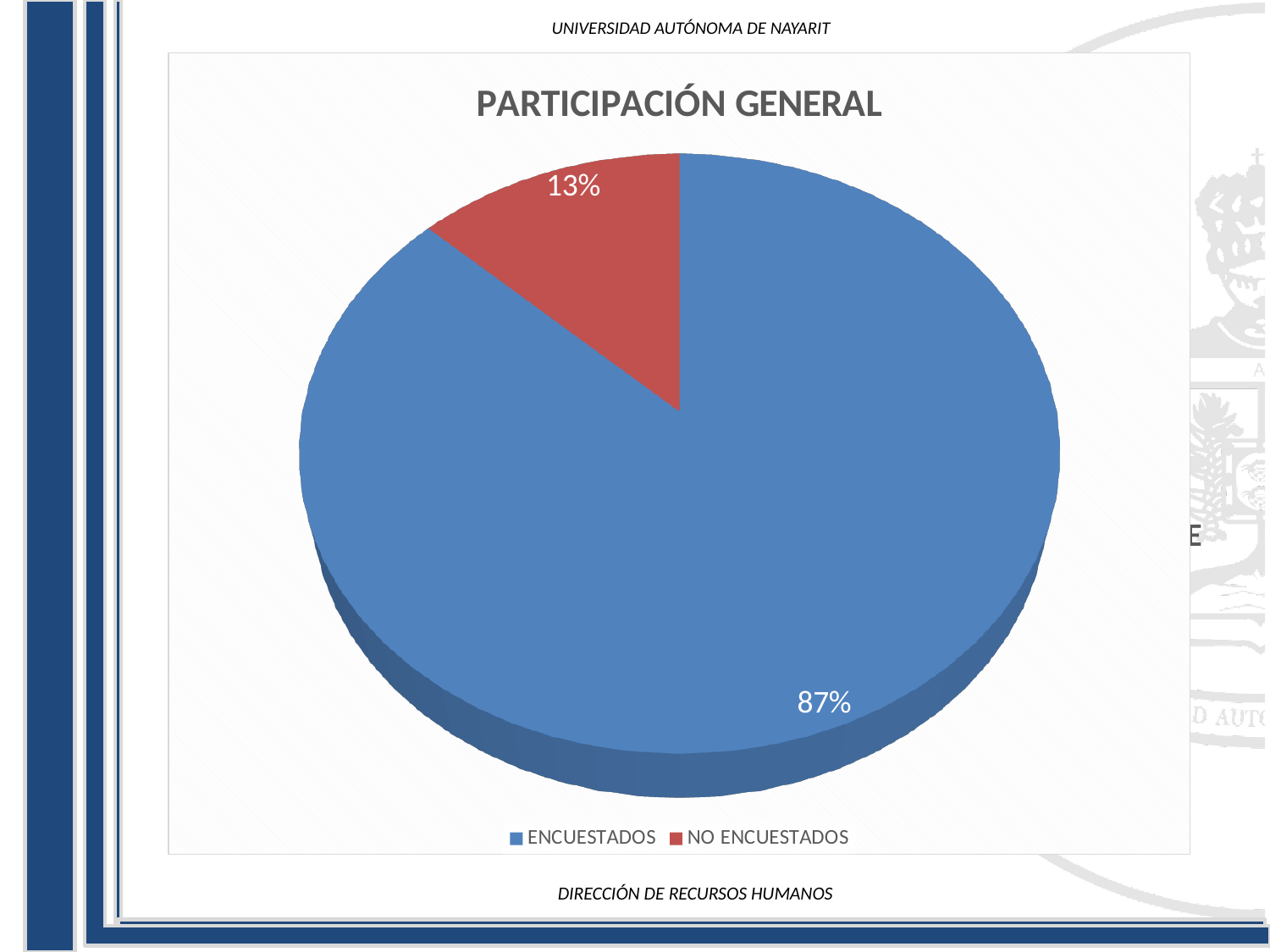
What share of the pie does NO ENCUESTADOS represent? 13% What kind of chart is shown on the slide? Pie chart How many entries does the legend list? 2 Which category has the smallest slice of the pie? NO ENCUESTADOS What is the difference in percentage points between ENCUESTADOS and NO ENCUESTADOS? 74 What colour is the NO ENCUESTADOS slice? Red What is the title of the chart? PARTICIPACIÓN GENERAL Which is larger, the ENCUESTADOS slice or the NO ENCUESTADOS slice? ENCUESTADOS What share of the pie does ENCUESTADOS represent? 87% How many categories does the pie chart show? 2 Which category has the largest slice of the pie? ENCUESTADOS